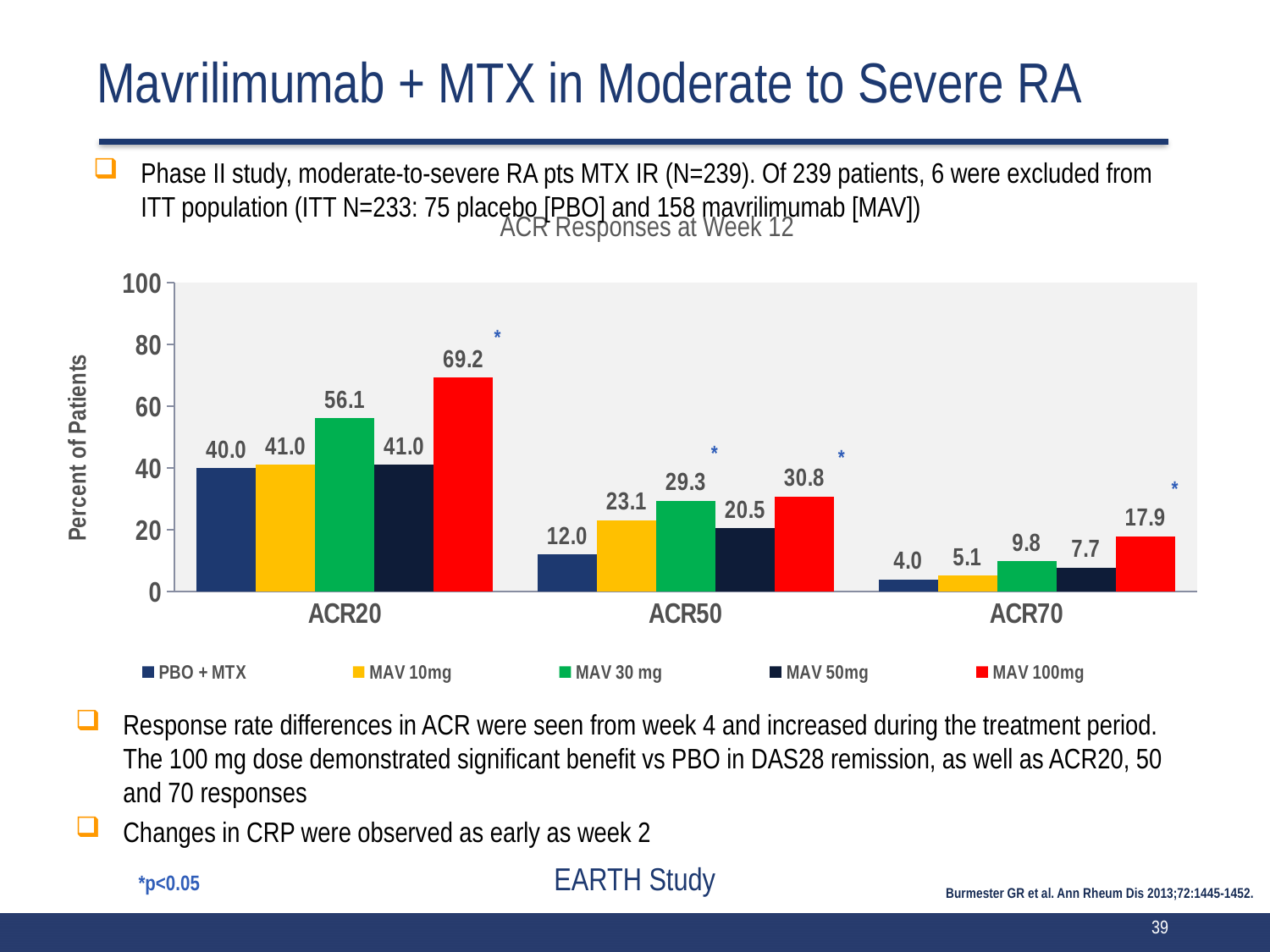
What is the ACR50 response rate for PBO + MTX? 12.0 What kind of chart is shown on the slide? Bar chart Which treatment group has the highest ACR50 response rate? MAV 100mg Which treatment group has the lowest ACR70 response rate? PBO + MTX Which is larger: the ACR50 response rate for MAV 30 mg or for MAV 50mg? MAV 30 mg Is the ACR20 value for MAV 30 mg greater or less than 40? greater What is the title of the chart? ACR Responses at Week 12 What is the ACR70 response rate for MAV 30 mg? 9.8 How many series does the legend list? 5 What is the ACR20 response rate for MAV 100mg? 69.2 What is the difference between the ACR20 response rates for MAV 100mg and PBO + MTX? 29.2 How many ACR response categories are shown on the x axis? 3